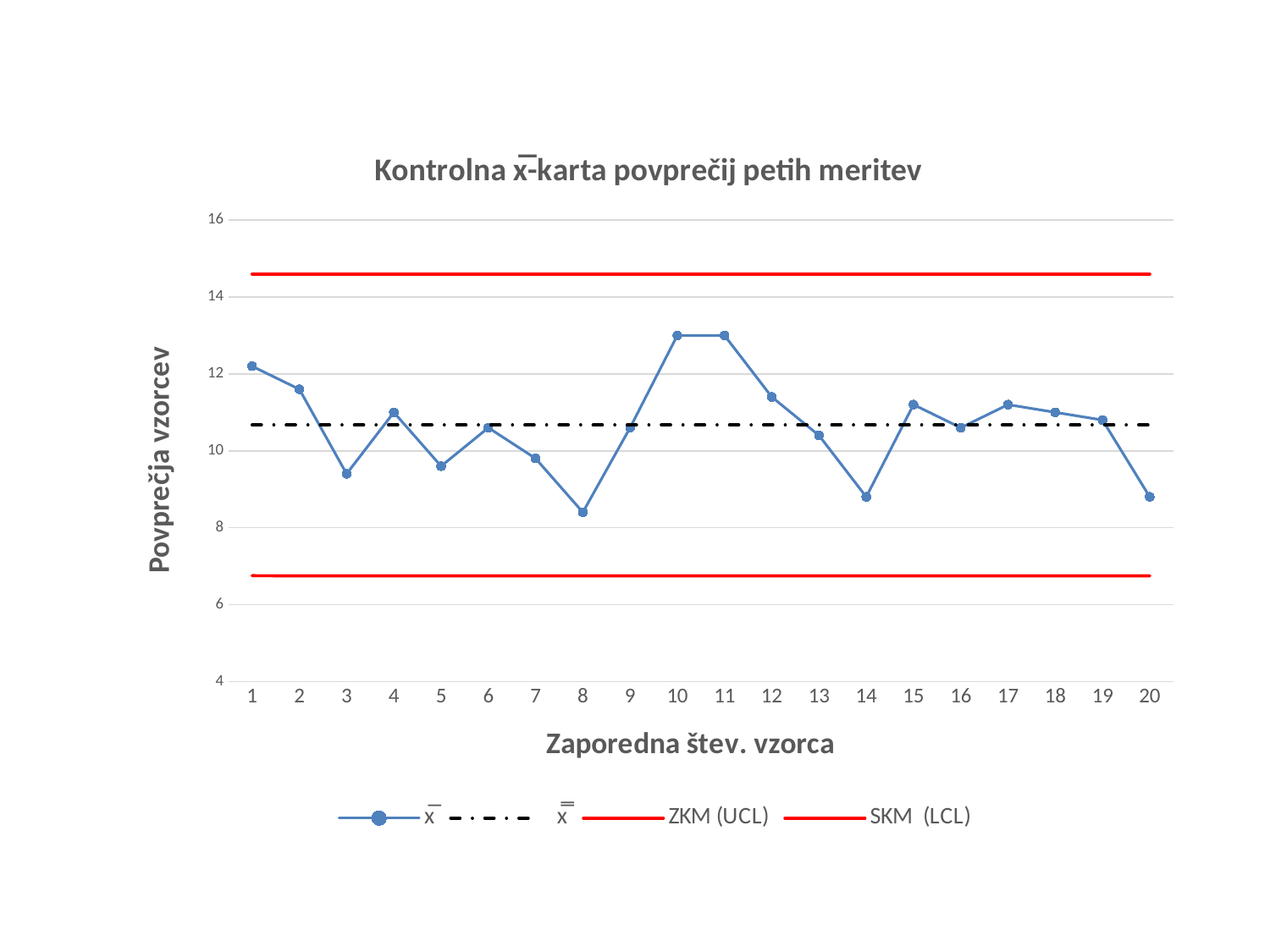
Do the values rise or fall from sample 8 to sample 10? rise Is the value for sample 8 greater or less than 10? less What is the x-axis title of the chart? Zaporedna štev. vzorca What kind of chart is shown on the slide? line chart How many sample points are plotted along the x axis? 20 How many series does the legend list? 4 Is the value for sample 14 greater or less than 10? less Is the SKM (LCL) line greater or less than 8? less What is the title of the chart? Kontrolna x̄-karta povprečij petih meritev Which has the larger value, sample 10 or sample 8? sample 10